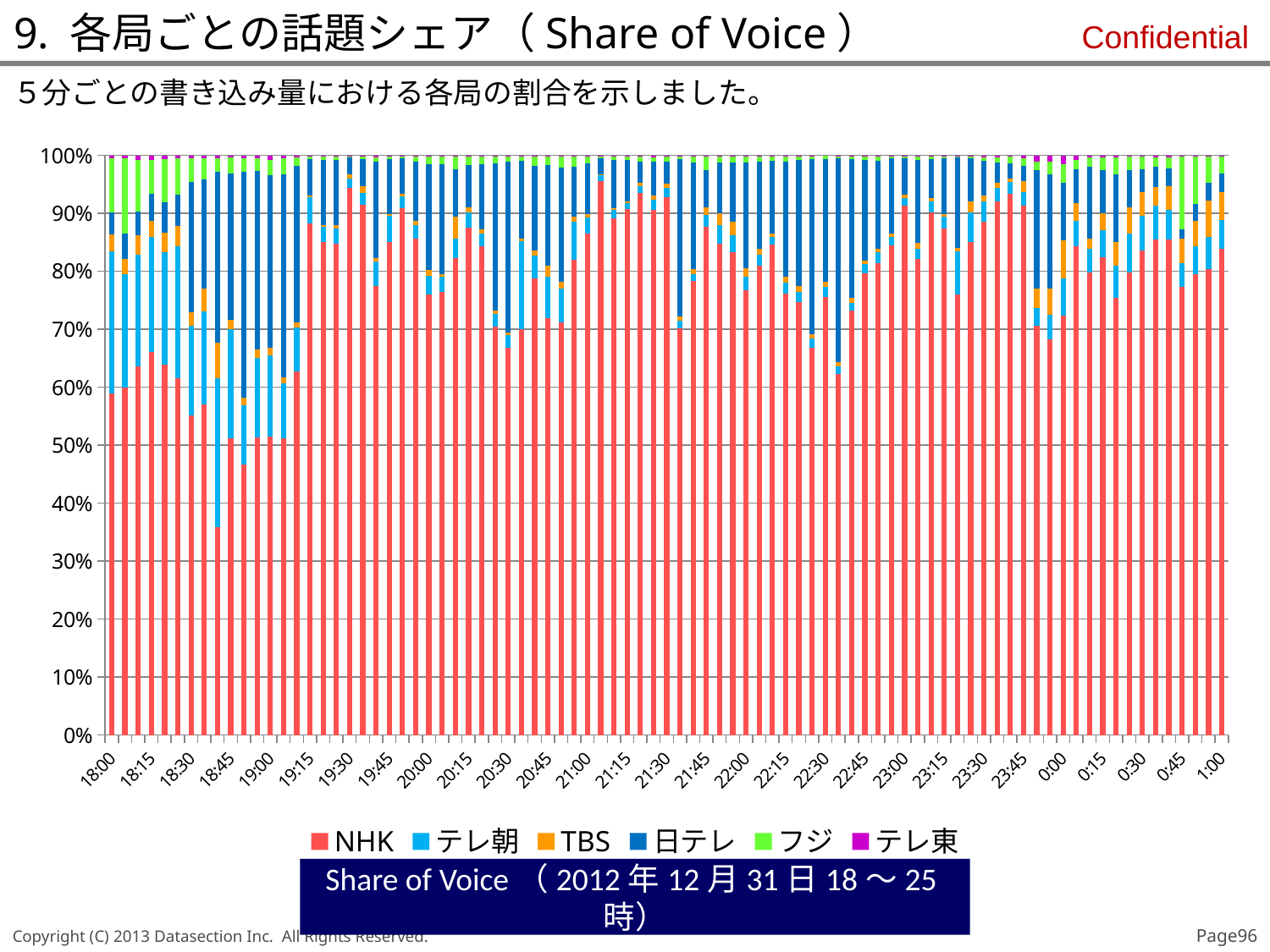
What colour represents フジ in the chart? green What kind of chart is shown on the slide? stacked bar chart What is the total of each stacked bar in the chart? 100% Which series is plotted at the bottom of each stacked bar? NHK Is the NHK share at 18:00 greater or less than 50%? greater Does the NHK share generally rise or fall from 18:00 to 19:30? rise How many time labels are shown on the x axis? 29 Is the NHK share at 1:00 greater or less than 90%? less Is the NHK share at 21:00 greater or less than 90%? less Is the NHK share larger at 18:00 or at 21:00? 21:00 How many series does the legend list? 6 Which series has the largest share at 18:00? NHK